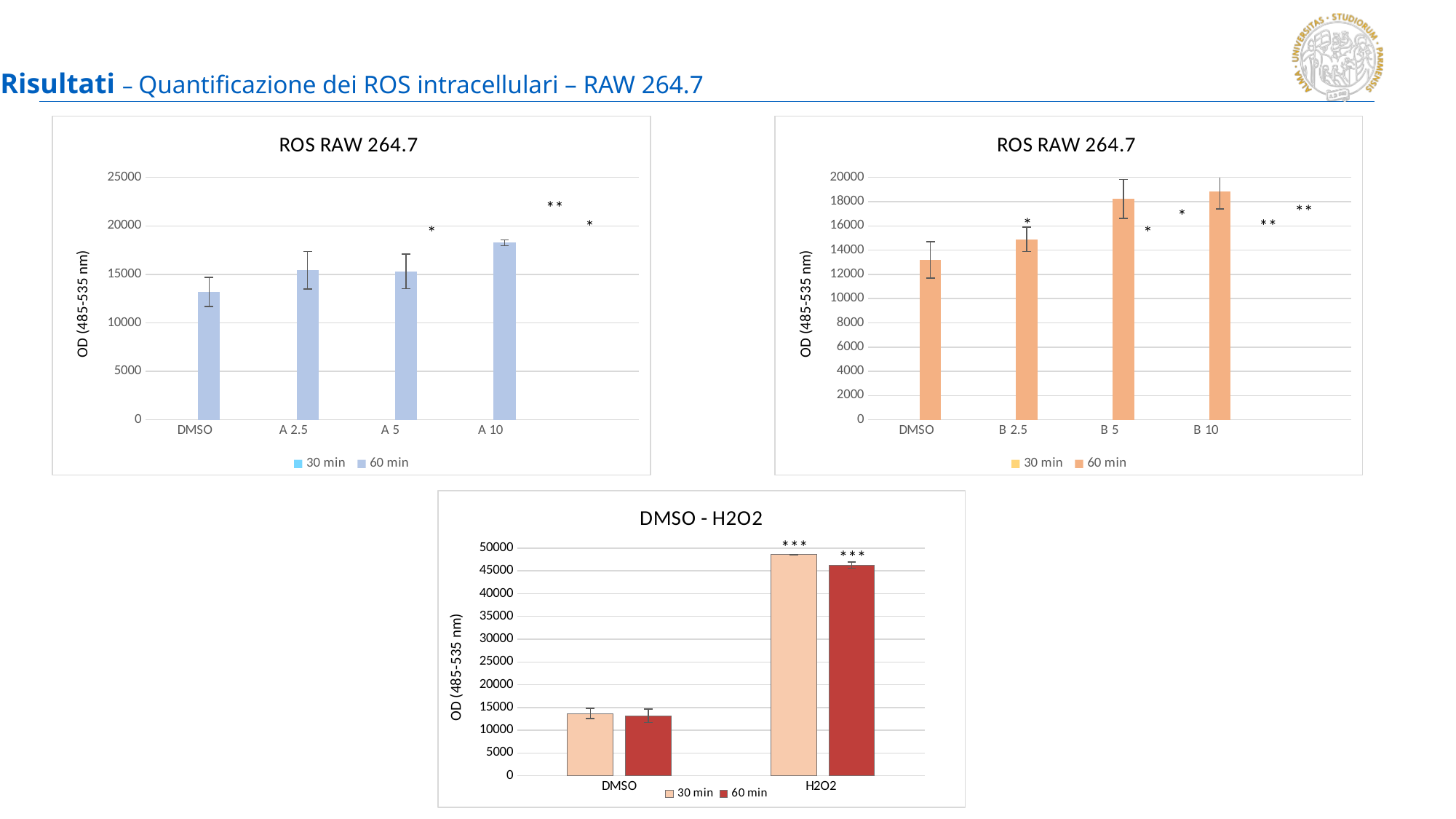
In the right chart (ROS RAW 264.7, B series), how many series does the legend list? 2 What type of chart is the bottom chart titled DMSO - H2O2? bar chart In the right chart (ROS RAW 264.7, B series), is the value for B 5 greater or less than 16000? greater In the left chart (ROS RAW 264.7, A series), which category has the highest value? A 10 In the bottom chart (DMSO - H2O2), which is larger, the 60 min value for DMSO or the 60 min value for H2O2? H2O2 In the left chart (ROS RAW 264.7, A series), which category has the lowest value? DMSO In the bottom chart (DMSO - H2O2), is the 30 min value for DMSO greater or less than 15000? less In the left chart (ROS RAW 264.7, A series), is the value for A 10 greater or less than 15000? greater In the left chart (ROS RAW 264.7, A series), how many categories are shown on the x axis? 4 In the right chart (ROS RAW 264.7, B series), which category has the lowest value? DMSO In the right chart (ROS RAW 264.7, B series), which is larger, the value for DMSO or the value for B 2.5? B 2.5